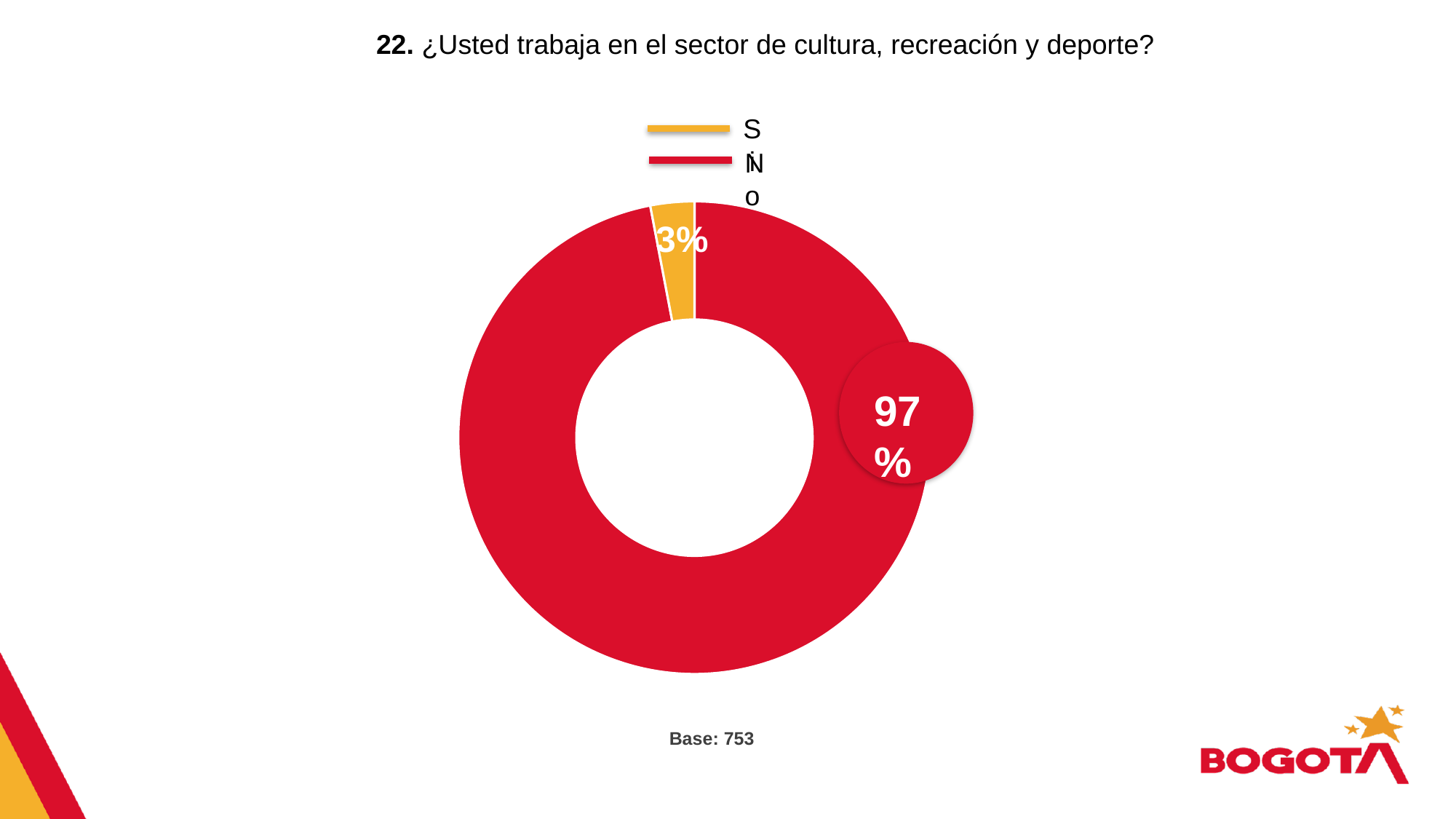
How many entries does the legend list? 2 What kind of chart is shown on the slide? Donut (pie) chart What colour is used for the "Sí" slice? Yellow What share of the chart does the "No" slice represent? 97% What is the base (number of respondents) shown below the chart? 753 Which response has the smallest share of the chart? Sí What percentage of respondents answered "No"? 97% How many categories are shown in the chart? 2 Which is larger, the share for "Sí" or the share for "No"? No What is the difference in percentage points between the "No" and "Sí" responses? 94 Which response has the largest share of the chart? No What percentage of respondents answered "Sí"? 3%